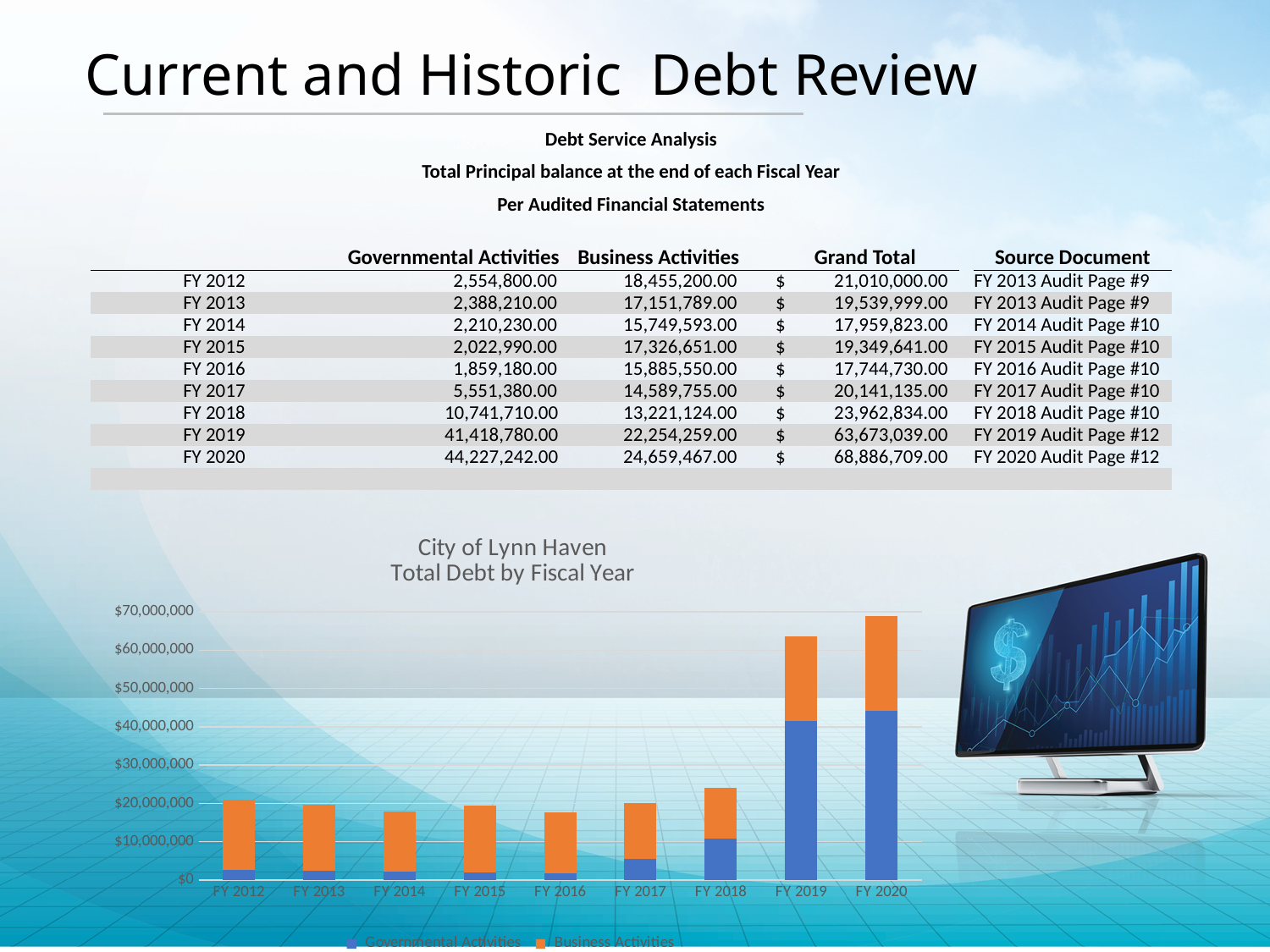
According to the table, what is the Business Activities balance for FY 2012? 18,455,200.00 In the 'Total Debt by Fiscal Year' chart, which is larger, the Governmental Activities segment for FY 2018 or for FY 2017? FY 2018 What kind of chart is 'City of Lynn Haven Total Debt by Fiscal Year'? stacked bar chart In the 'Total Debt by Fiscal Year' chart, is the total bar for FY 2016 greater or less than $20,000,000? less In the 'Total Debt by Fiscal Year' chart, do the total bars rise or fall from FY 2017 to FY 2020? rise How many series does the legend of the 'Total Debt by Fiscal Year' chart list? 2 Which colour represents Business Activities in the 'Total Debt by Fiscal Year' chart? orange According to the table, what is the Grand Total for FY 2020? $ 68,886,709.00 Which fiscal year has the tallest bar in the 'Total Debt by Fiscal Year' chart? FY 2020 In the 'Total Debt by Fiscal Year' chart, is the Governmental Activities segment for FY 2020 greater or less than $40,000,000? greater In the 'Total Debt by Fiscal Year' chart, is the total bar for FY 2019 greater or less than $60,000,000? greater How many fiscal years are shown on the x axis of the 'Total Debt by Fiscal Year' chart? 9